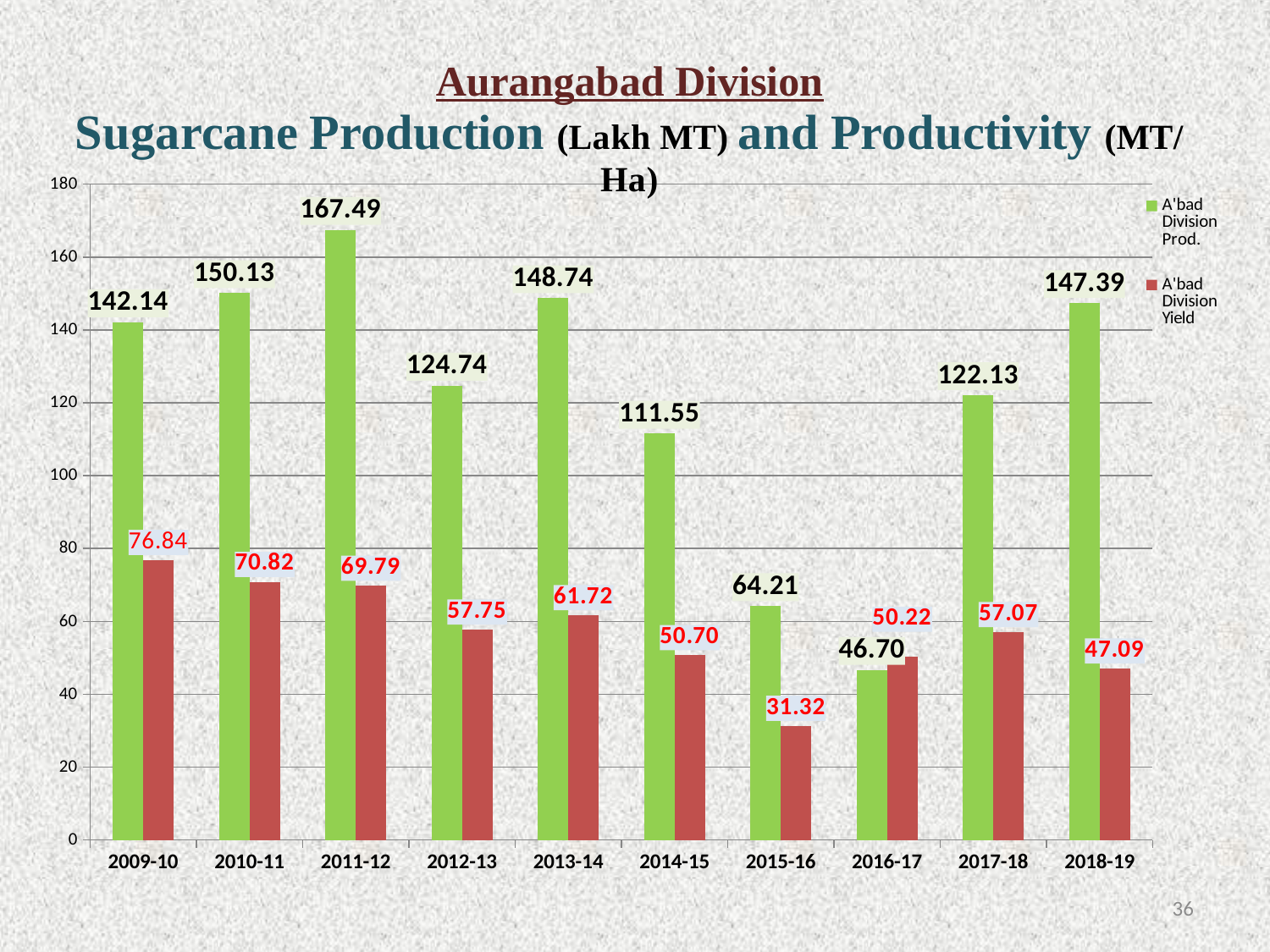
How many years are shown on the x axis? 10 Is the A'bad Division Prod. value for 2014-15 greater or less than 100? greater What kind of chart is shown on the slide? Bar chart What is the A'bad Division Prod. value for 2016-17? 46.70 Which is larger, the A'bad Division Yield for 2016-17 or for 2018-19? 2016-17 Which year has the lowest A'bad Division Yield value? 2015-16 Which year has the highest A'bad Division Prod. value? 2011-12 How many series does the legend list? 2 What is the A'bad Division Yield value for 2013-14? 61.72 Which colour represents A'bad Division Yield in the chart? Red What is the A'bad Division Prod. value for 2011-12? 167.49 What is the difference between the A'bad Division Prod. values for 2010-11 and 2009-10? 7.99